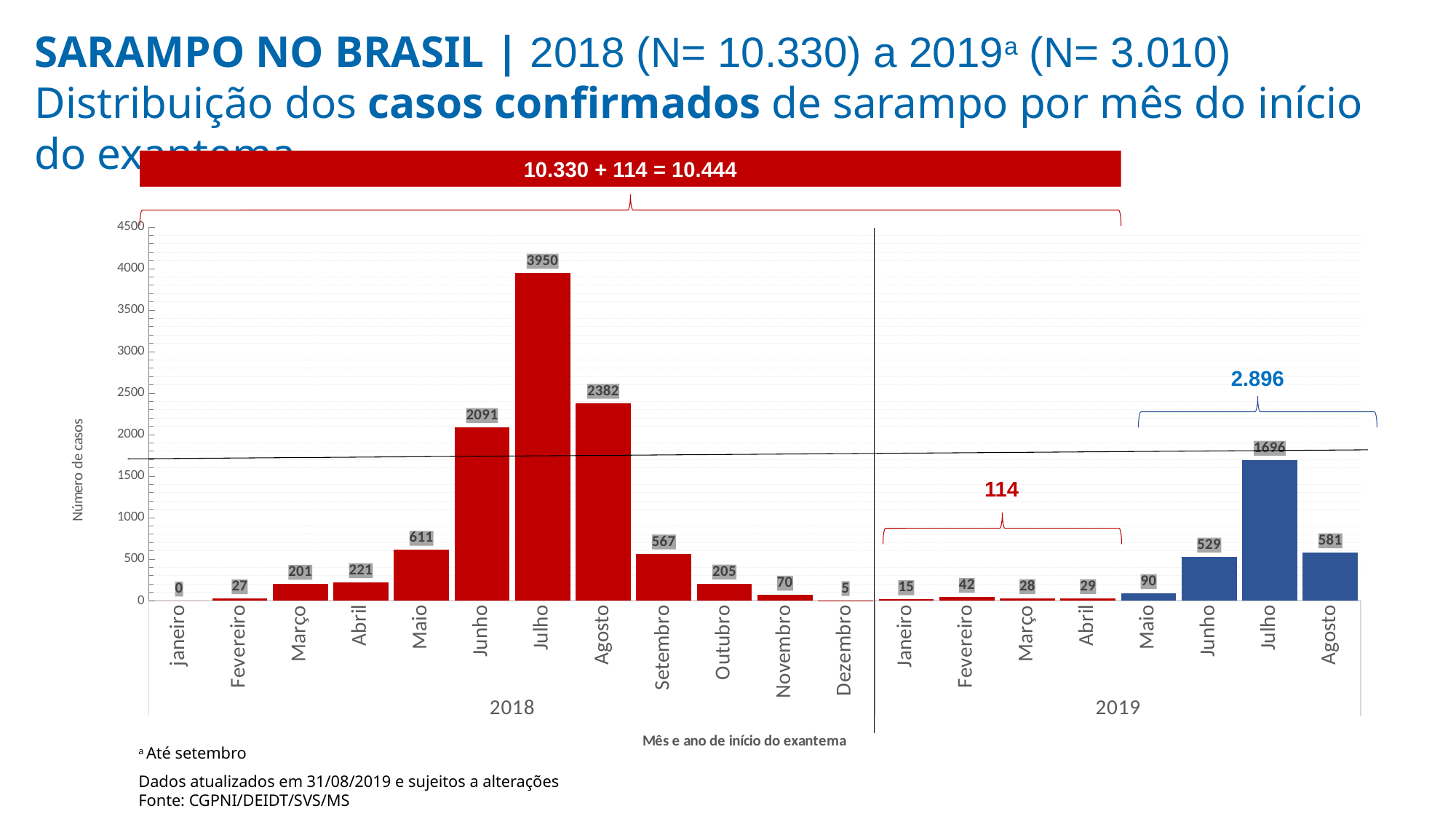
Which is larger, the value for Junho 2018 or Agosto 2018? Agosto 2018 What is the difference between the values for Julho 2018 and Julho 2019? 2254 How many confirmed measles cases are shown for Julho 2018? 3950 Which month has the lowest number of cases in the chart? Janeiro 2018 Do the values rise or fall from Julho 2018 to Dezembro 2018? fall What kind of chart is shown on the slide? bar chart What is the label of the vertical axis? Número de casos Which month has the highest number of cases in the chart? Julho 2018 How many monthly bars are plotted in the chart? 20 Is the value for Maio 2018 greater or less than 500? greater What is the value for Julho 2019? 1696 What is the value for Setembro 2018? 567